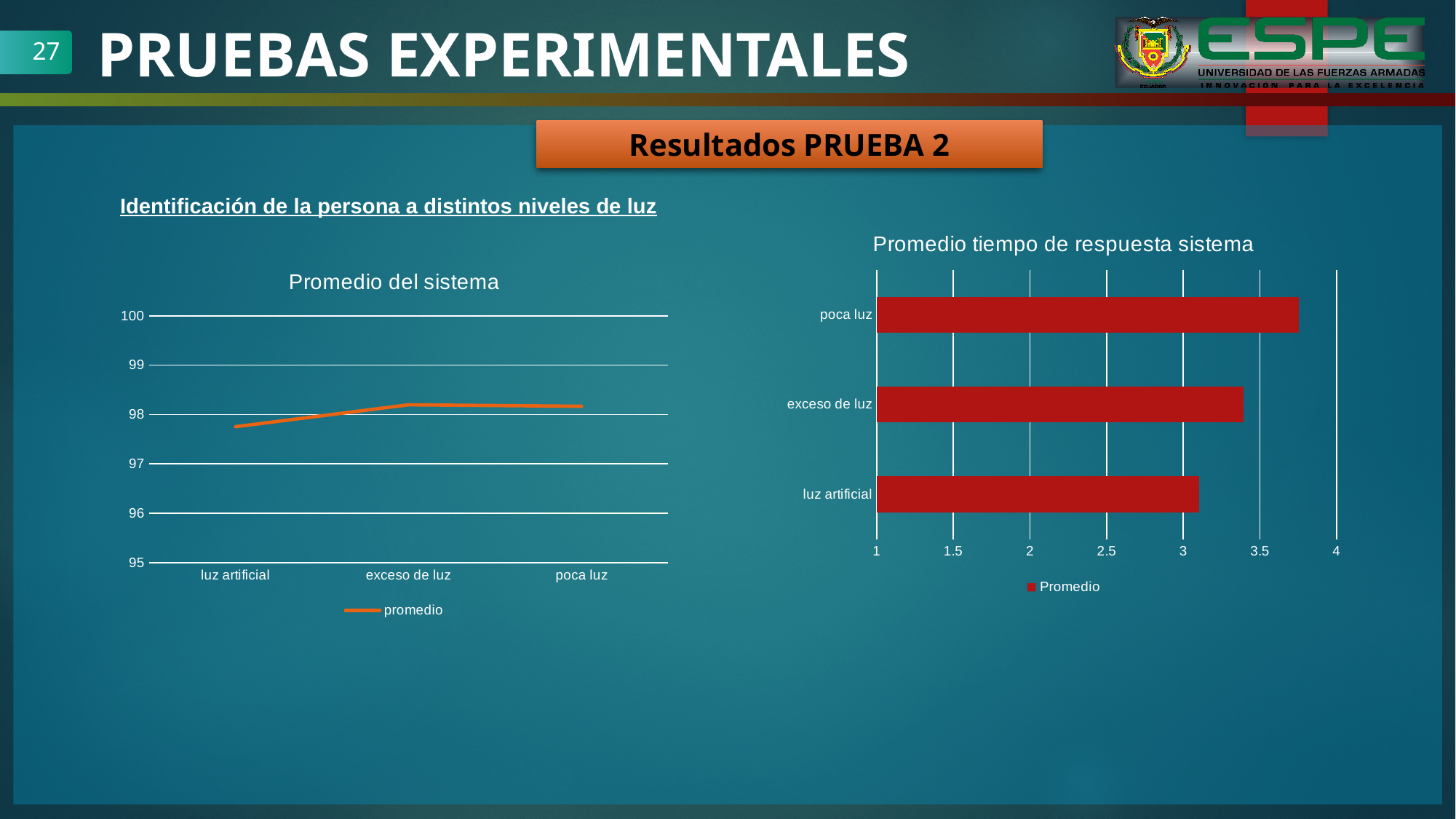
What kind of chart is the 'Promedio del sistema' chart on the left? line chart How many categories are shown on the x axis of the 'Promedio del sistema' chart? 3 In the 'Promedio tiempo de respuesta sistema' chart, which category has the longest bar? poca luz How many bars are in the 'Promedio tiempo de respuesta sistema' chart? 3 In the 'Promedio del sistema' chart, which category has the lowest value? luz artificial In the 'Promedio tiempo de respuesta sistema' chart, which category has the shortest bar? luz artificial How many series does the legend of the 'Promedio tiempo de respuesta sistema' chart list? 1 What is the name of the series in the legend of the 'Promedio del sistema' chart? promedio In the 'Promedio tiempo de respuesta sistema' chart, is the value for poca luz greater or less than 3.5? greater What kind of chart is the 'Promedio tiempo de respuesta sistema' chart on the right? bar chart In the 'Promedio del sistema' chart, is the value for luz artificial greater or less than 98? less In the 'Promedio tiempo de respuesta sistema' chart, which is larger, the value for poca luz or the value for luz artificial? poca luz